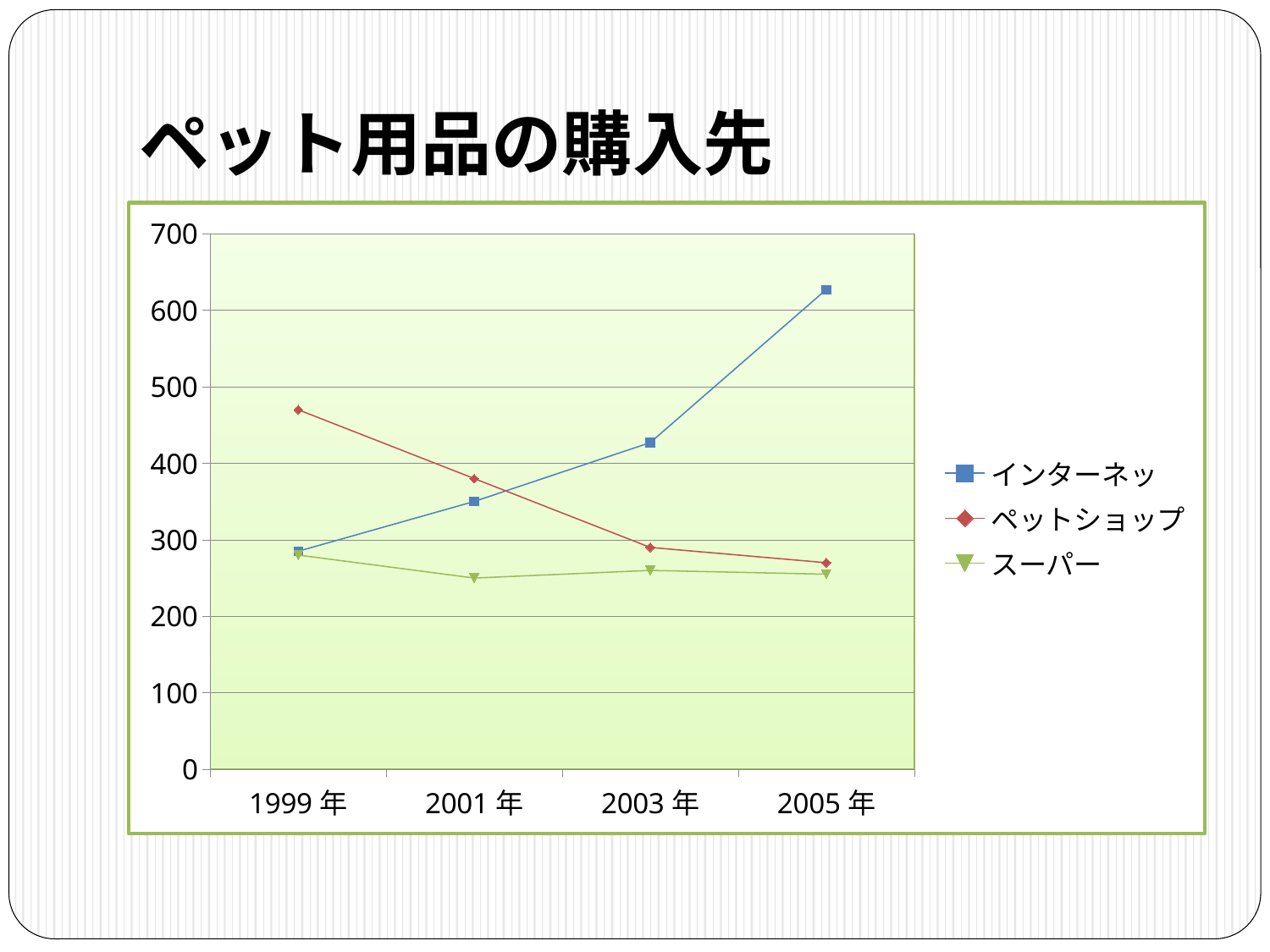
Is the value for インターネッ in 2005年 greater or less than 600? greater Does the ペットショップ series rise or fall from 1999年 to 2005年? fall Is the value for スーパー in 2001年 greater or less than 300? less What kind of chart is shown on the slide? line chart What is the title of the slide? ペット用品の購入先 How many series does the legend list? 3 Does the インターネッ series rise or fall from 1999年 to 2005年? rise How many years are plotted along the x axis? 4 Which series has the highest value in 1999年? ペットショップ Is the value for ペットショップ in 1999年 greater or less than 400? greater Which series has the highest value in 2005年? インターネッ Which series has the lowest value in 2001年? スーパー